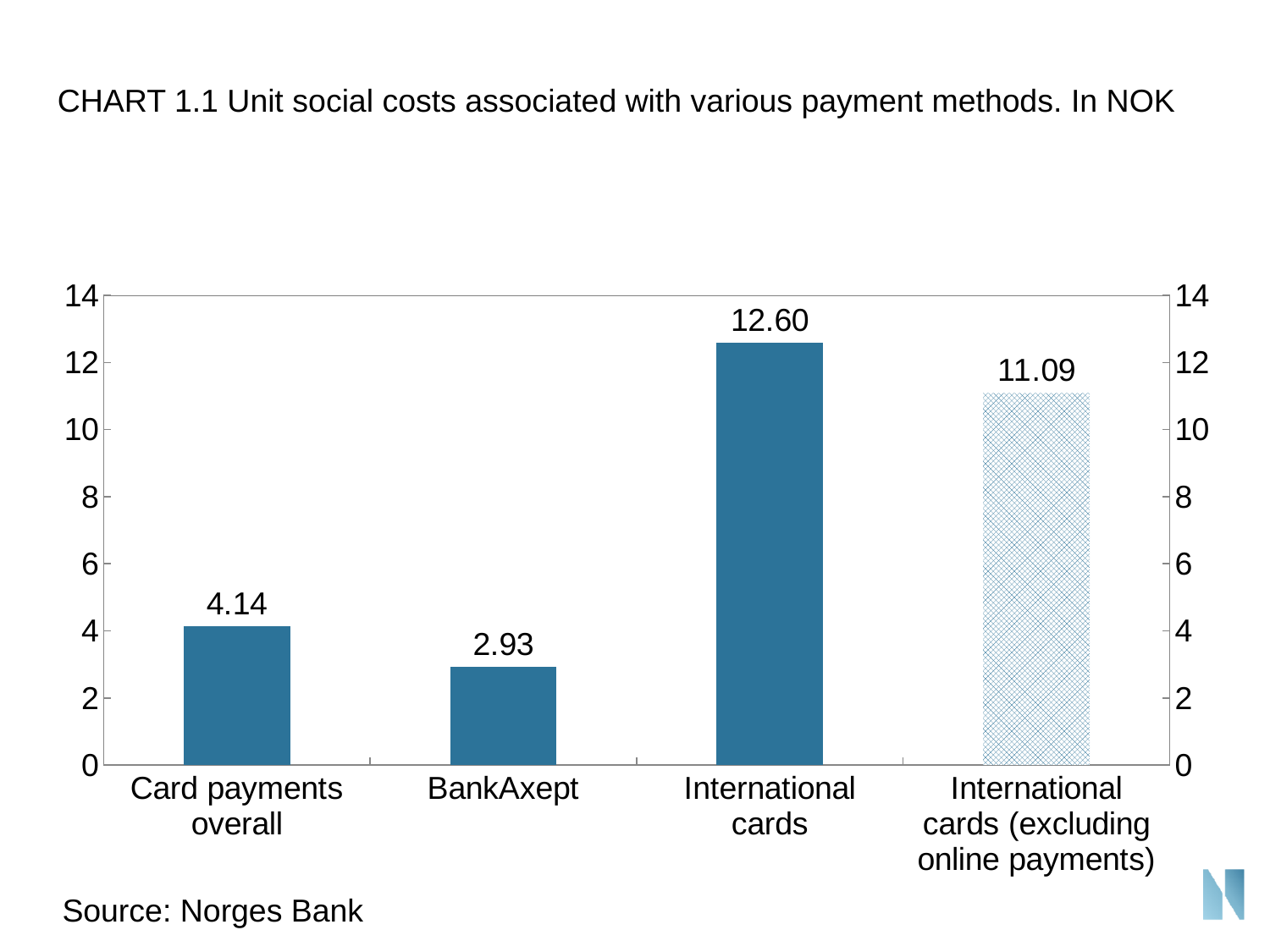
What is the difference in unit social cost between International cards and International cards (excluding online payments)? 1.51 How many payment methods are shown in the chart? 4 What type of chart is shown on the slide? Bar chart Which payment method has the highest unit social cost? International cards Which payment method has the lowest unit social cost? BankAxept What is the difference in unit social cost between International cards and BankAxept? 9.67 What is the unit social cost for BankAxept? 2.93 Which has a higher unit social cost, Card payments overall or BankAxept? Card payments overall What is the source cited for the chart? Norges Bank What is the unit social cost for International cards (excluding online payments)? 11.09 What is the unit social cost for Card payments overall? 4.14 What is the unit social cost for International cards? 12.60